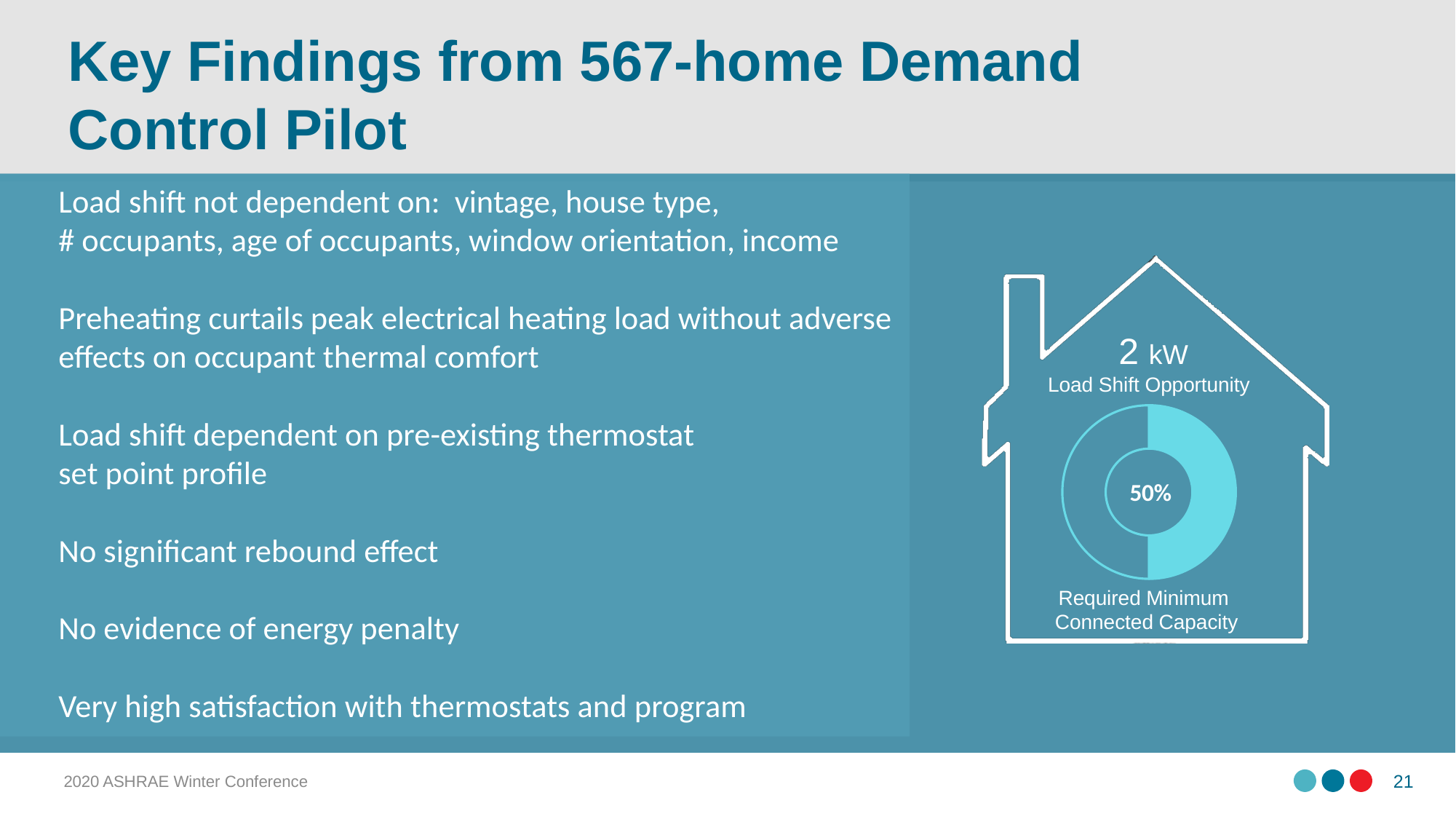
What percentage is printed in the centre of the donut chart? 50% What label appears directly under the '2 kW' value above the donut chart? Load Shift Opportunity What load shift opportunity value is printed above the donut chart? 2 kW Is the filled portion of the donut chart greater or less than 75%? less Is the filled portion of the donut chart greater or less than 25%? greater What label appears below the donut chart? Required Minimum Connected Capacity What kind of chart is shown inside the house outline on the right of the slide? Pie chart (donut) What share of the donut chart is filled by the light blue slice? 50%